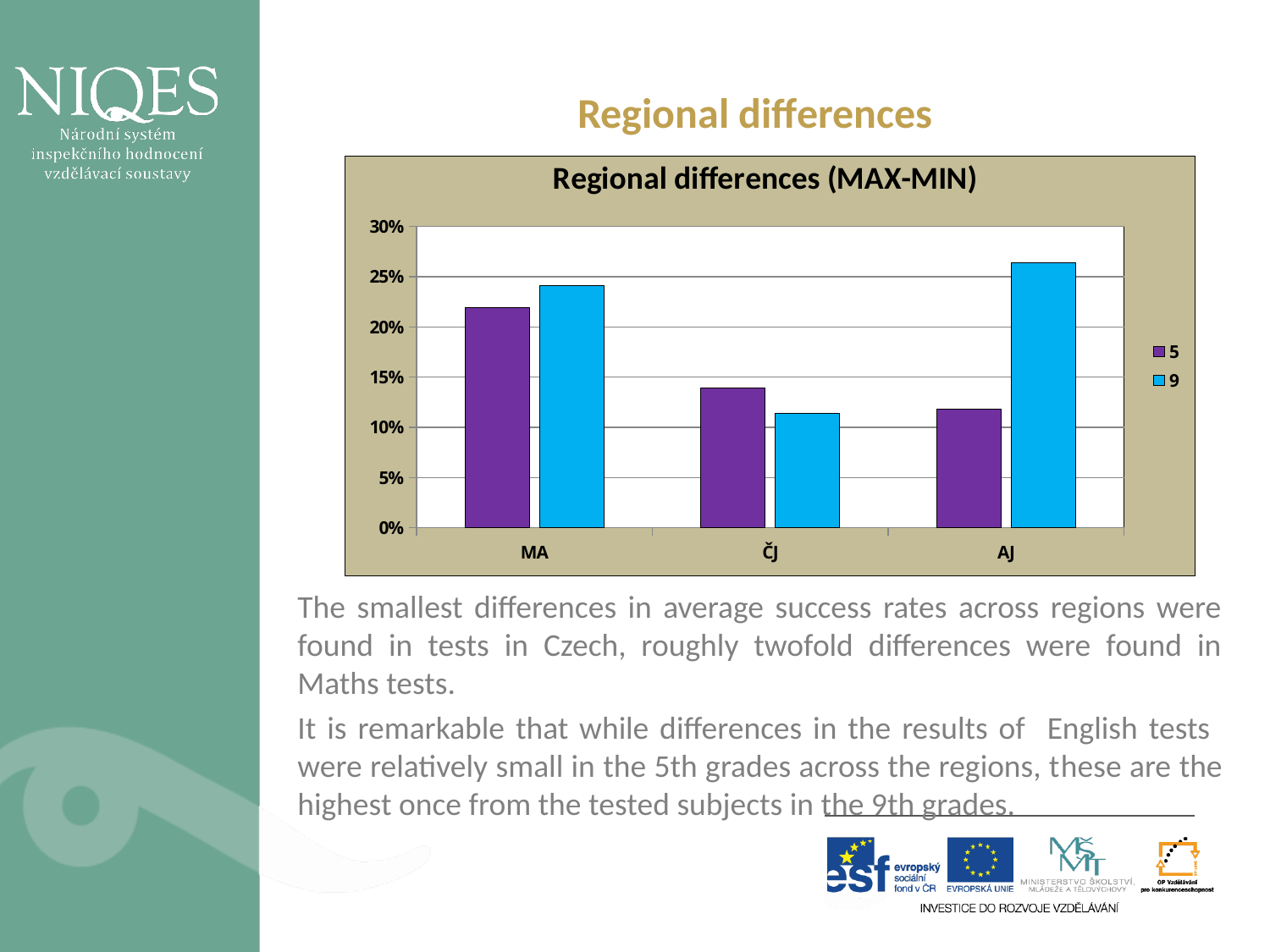
Is the value for series 5 in ČJ greater or less than 15%? less For series 9, which category has the lowest value? ČJ For series 5, which category has the highest value? MA How many series does the chart's legend list? 2 In the AJ category, which series has the larger value, 5 or 9? 9 Is the value for series 9 in AJ greater or less than 25%? greater For series 9, which category has the highest value? AJ What are the two series named in the legend? 5 and 9 How many categories are shown on the x axis of the chart? 3 What is the title of the chart? Regional differences (MAX-MIN) Is the value for series 5 in MA greater or less than 20%? greater What kind of chart is shown on the slide? bar chart